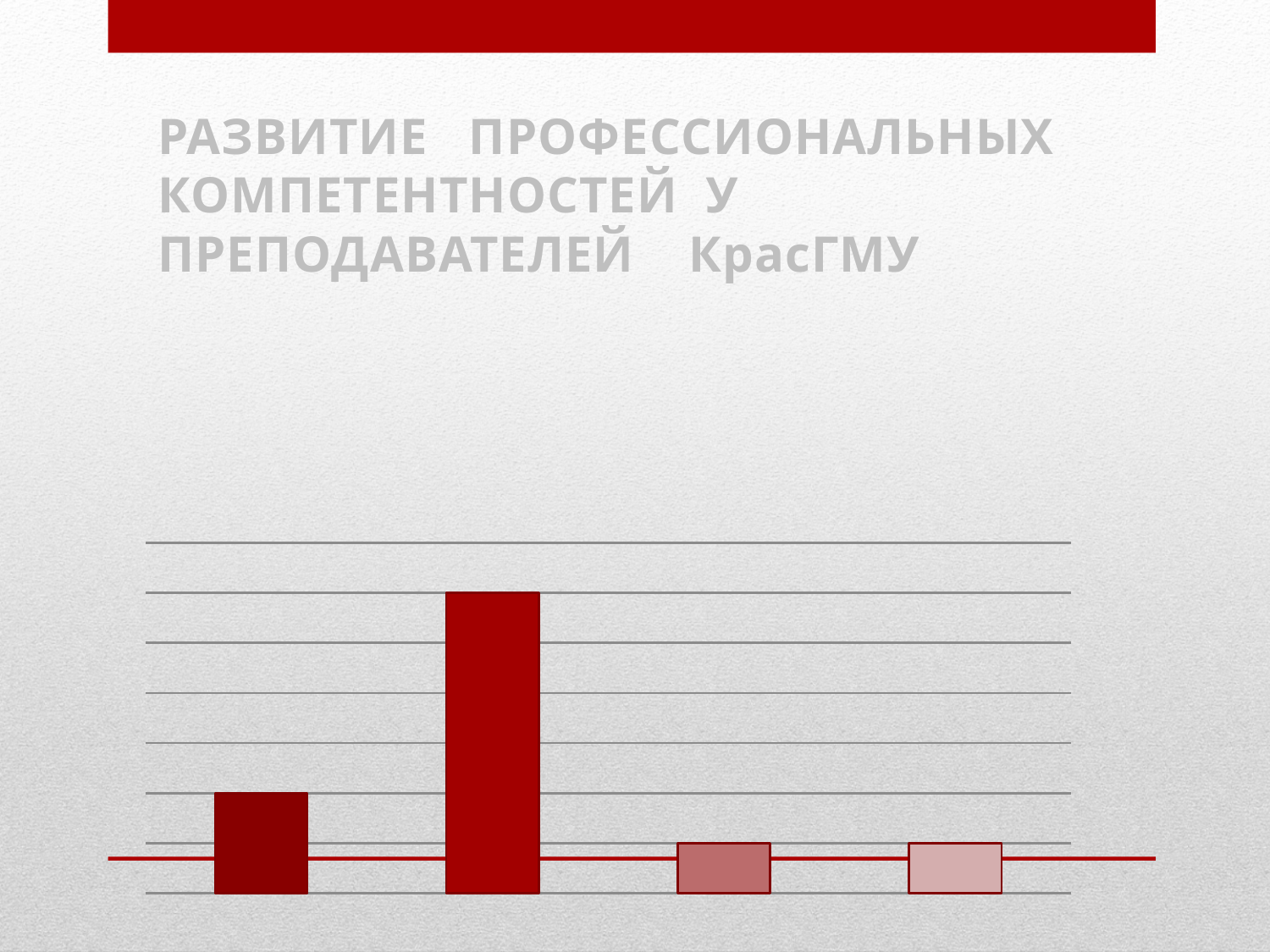
What kind of chart is shown on the slide? bar chart Do the bar heights rise or fall from the second bar to the third bar in the chart? fall Which bar in the chart is the tallest, counting from the left? the second bar Which is taller in the chart: the second bar from the left or the fourth bar from the left? the second bar Which is taller in the chart: the first bar from the left or the third bar from the left? the first bar Which is taller in the chart: the first bar from the left or the second bar from the left? the second bar How many bars does the chart on the slide contain? 4 Are the bars in the chart vertical or horizontal? vertical Does the chart on the slide display a legend? No